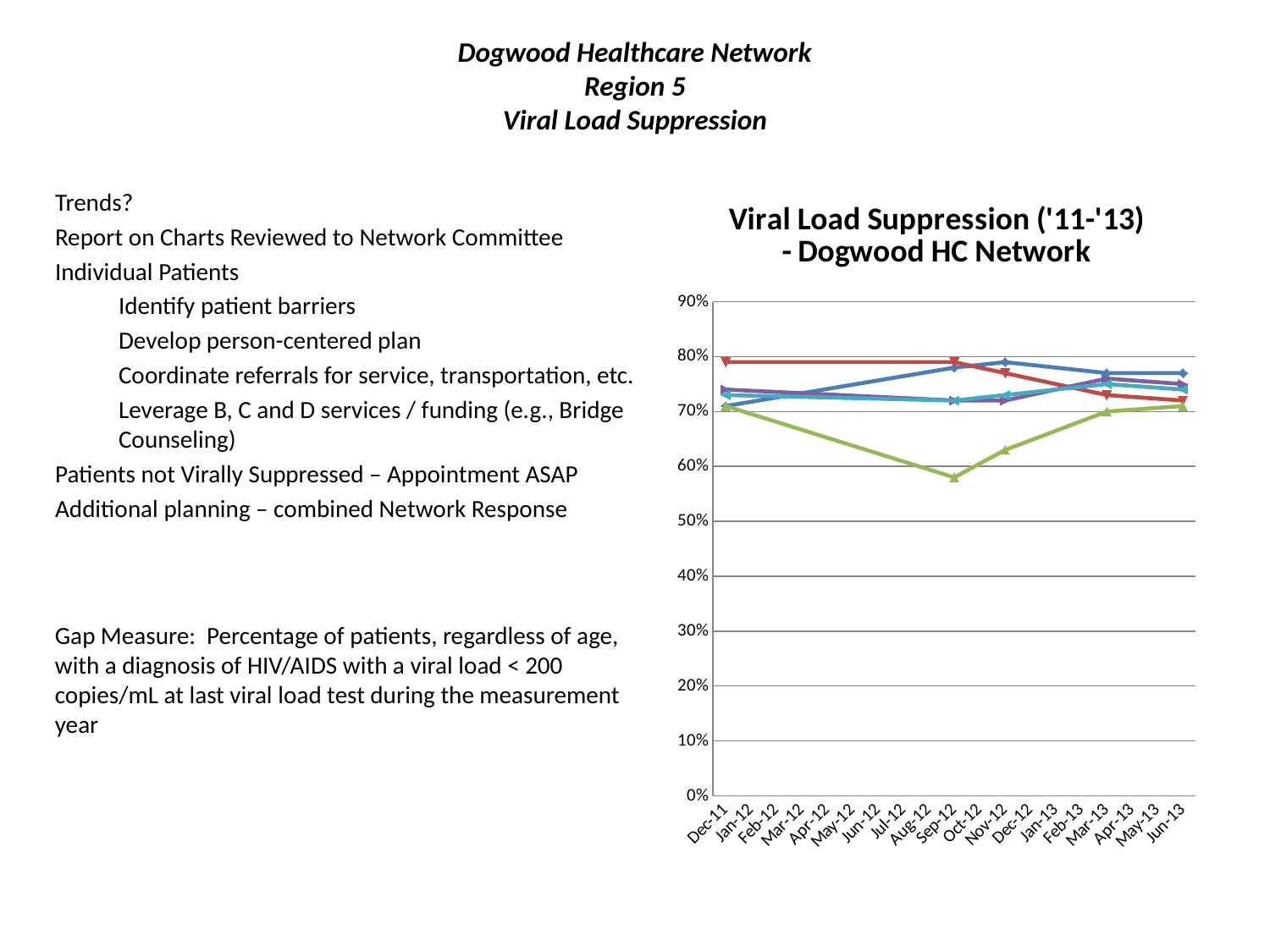
How many month labels are shown along the x axis of the chart? 19 Does the green line rise or fall between Dec-11 and Sep-12? fall Is the value of the blue line at Nov-12 greater or less than 70%? greater At which month does the green line reach its lowest value? Sep-12 Is the value of the green line at Nov-12 greater or less than 70%? less What is the title of the chart? Viral Load Suppression ('11-'13) - Dogwood HC Network How many lines are plotted on the chart? 5 Is the value of the green line at Sep-12 greater or less than 60%? less What is the highest value shown on the y axis of the chart? 90% What kind of chart is shown on the slide? line chart Which line is lowest at Sep-12, the green line or the red line? green line